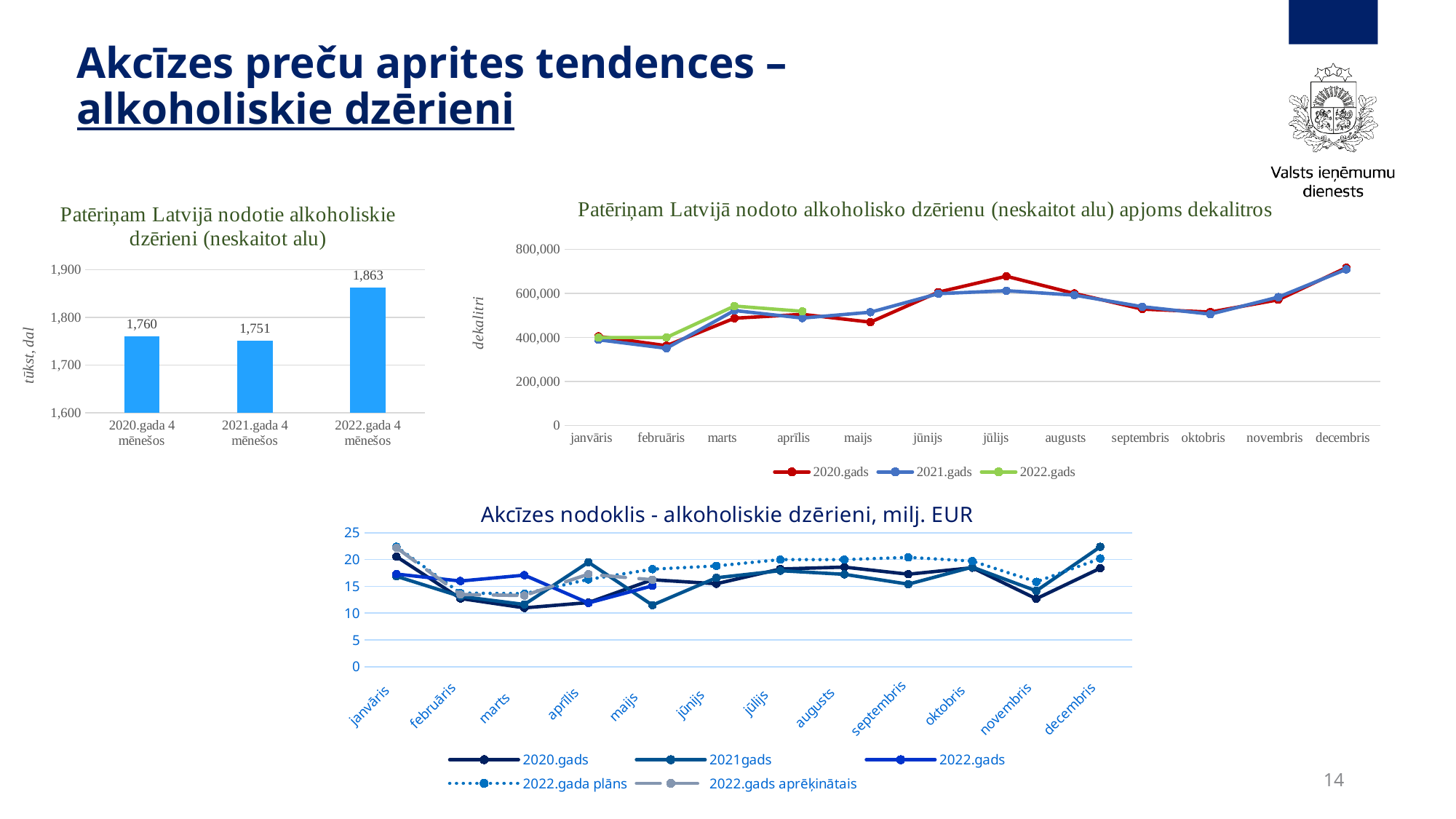
How many series does the legend of the chart 'Akcīzes nodoklis - alkoholiskie dzērieni, milj. EUR' list? 5 In the chart 'Patēriņam Latvijā nodoto alkoholisko dzērienu (neskaitot alu) apjoms dekalitros', is the value for 2020.gads in jūlijs greater or less than 600,000? greater In the bar chart 'Patēriņam Latvijā nodotie alkoholiskie dzērieni (neskaitot alu)', what is the difference between the values for 2022.gada 4 mēnešos and 2020.gada 4 mēnešos? 103 In the bar chart 'Patēriņam Latvijā nodotie alkoholiskie dzērieni (neskaitot alu)', which category has the highest value? 2022.gada 4 mēnešos How many series does the legend of the chart 'Patēriņam Latvijā nodoto alkoholisko dzērienu (neskaitot alu) apjoms dekalitros' list? 3 In the chart 'Patēriņam Latvijā nodoto alkoholisko dzērienu (neskaitot alu) apjoms dekalitros', is the value for 2021.gads in februāris greater or less than 400,000? less In the bar chart 'Patēriņam Latvijā nodotie alkoholiskie dzērieni (neskaitot alu)', how many bars are shown? 3 In the bar chart 'Patēriņam Latvijā nodotie alkoholiskie dzērieni (neskaitot alu)', what is the value for 2020.gada 4 mēnešos? 1,760 In the bar chart 'Patēriņam Latvijā nodotie alkoholiskie dzērieni (neskaitot alu)', what is the value for 2022.gada 4 mēnešos? 1,863 What kind of chart is 'Patēriņam Latvijā nodotie alkoholiskie dzērieni (neskaitot alu)'? bar chart In the bar chart 'Patēriņam Latvijā nodotie alkoholiskie dzērieni (neskaitot alu)', which category has the lowest value? 2021.gada 4 mēnešos In the chart 'Patēriņam Latvijā nodoto alkoholisko dzērienu (neskaitot alu) apjoms dekalitros', in which month does the 2021.gads series reach its highest value? decembris